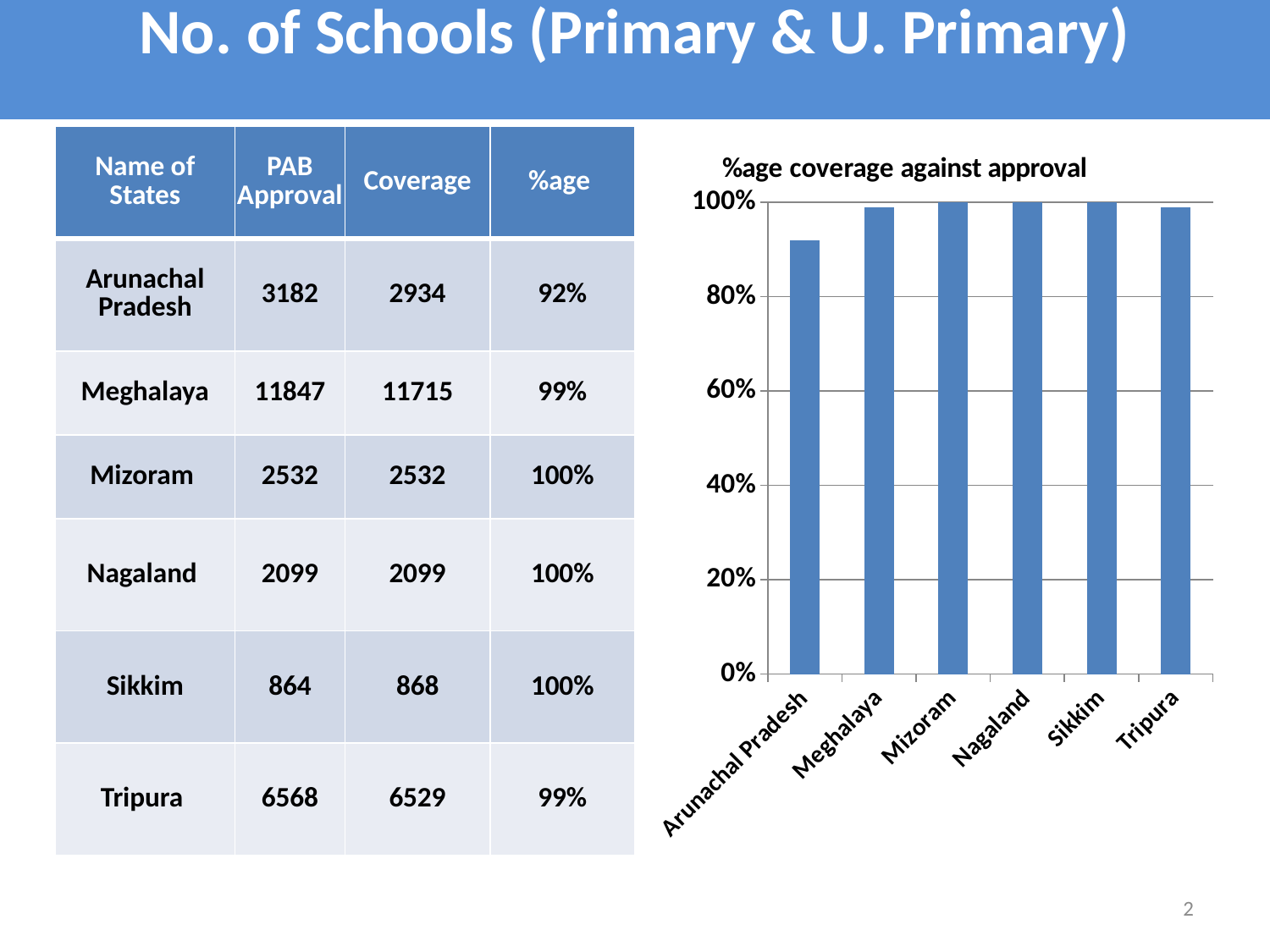
Which state has the lowest %age coverage against approval on the chart? Arunachal Pradesh Is the value for Meghalaya greater or less than 80%? greater What is the %age coverage against approval for Nagaland? 100% What is the title of the chart? %age coverage against approval How many states are plotted on the chart? 6 What is the difference in %age coverage between Meghalaya and Arunachal Pradesh? 7% What is the %age coverage against approval for Arunachal Pradesh? 92% Is the value for Arunachal Pradesh greater or less than 80%? greater What is the %age coverage against approval for Tripura? 99% What kind of chart is shown on the slide? bar chart Which is larger on the chart, the value for Mizoram or the value for Arunachal Pradesh? Mizoram Which is larger on the chart, the value for Arunachal Pradesh or the value for Meghalaya? Meghalaya